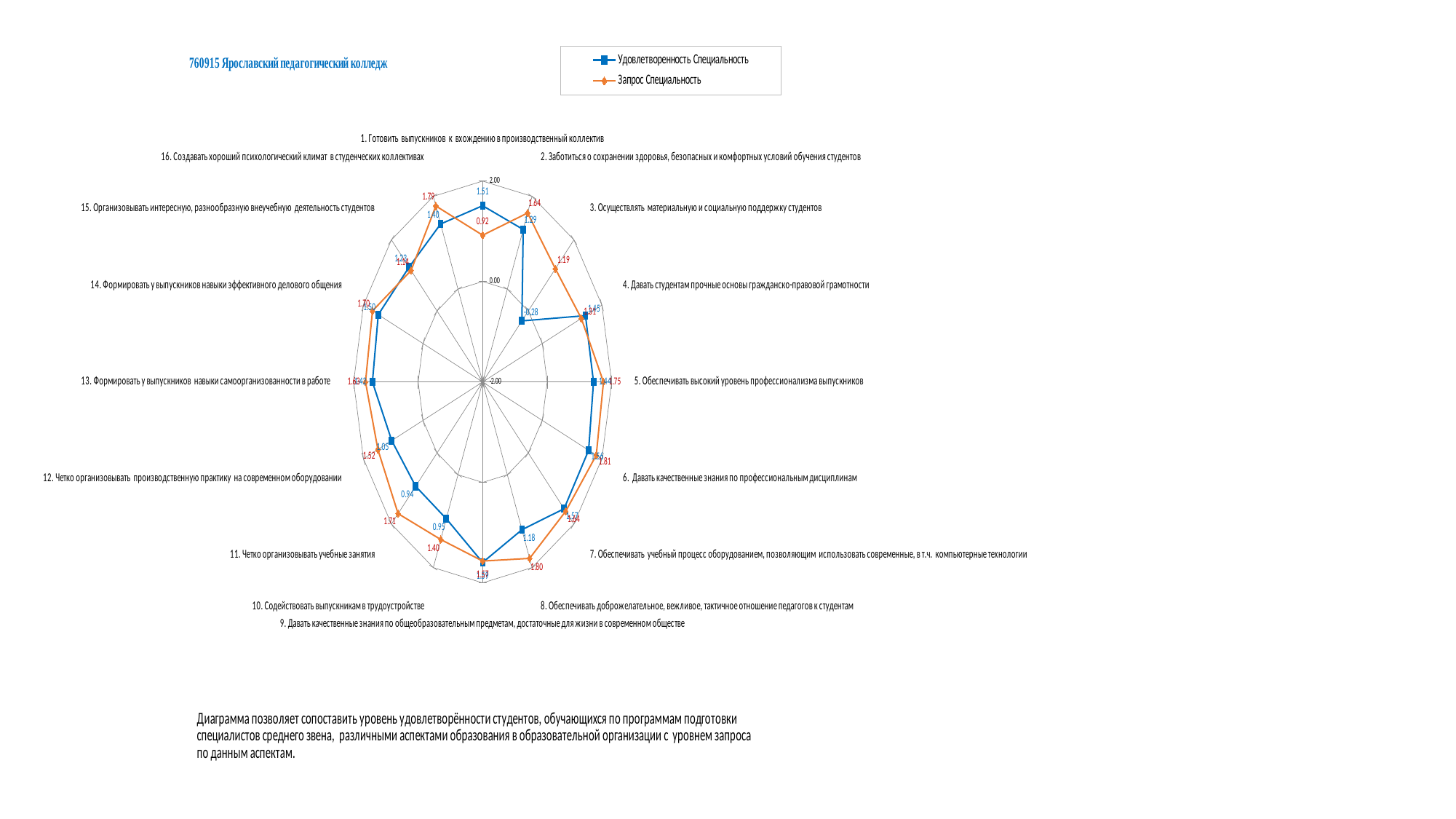
What is the Удовлетворенность Специальность value for category 11 (Четко организовывать учебные занятия)? 0.94 What is the title shown above the chart? 760915 Ярославский педагогический колледж Which category has the lowest Удовлетворенность Специальность value? 3. Осуществлять материальную и социальную поддержку студентов Which category has the lowest Запрос Специальность value? 1. Готовить выпускников к вхождению в производственный коллектив For category 2 (Заботиться о сохранении здоровья, безопасных и комфортных условий обучения студентов), which series has the larger value: Удовлетворенность Специальность or Запрос Специальность? Запрос Специальность How many series does the legend list? 2 What is the Запрос Специальность value for category 8 (Обеспечивать доброжелательное, вежливое, тактичное отношение педагогов к студентам)? 1.80 What is the Удовлетворенность Специальность value for category 1 (Готовить выпускников к вхождению в производственный коллектив)? 1.51 What kind of chart is shown on the slide? Radar chart What is the difference between the Запрос Специальность and Удовлетворенность Специальность values for category 8 (Обеспечивать доброжелательное, вежливое, тактичное отношение педагогов к студентам)? 0.62 What is the Запрос Специальность value for category 1 (Готовить выпускников к вхождению в производственный коллектив)? 0.92 How many categories (axes) does the radar chart have? 16